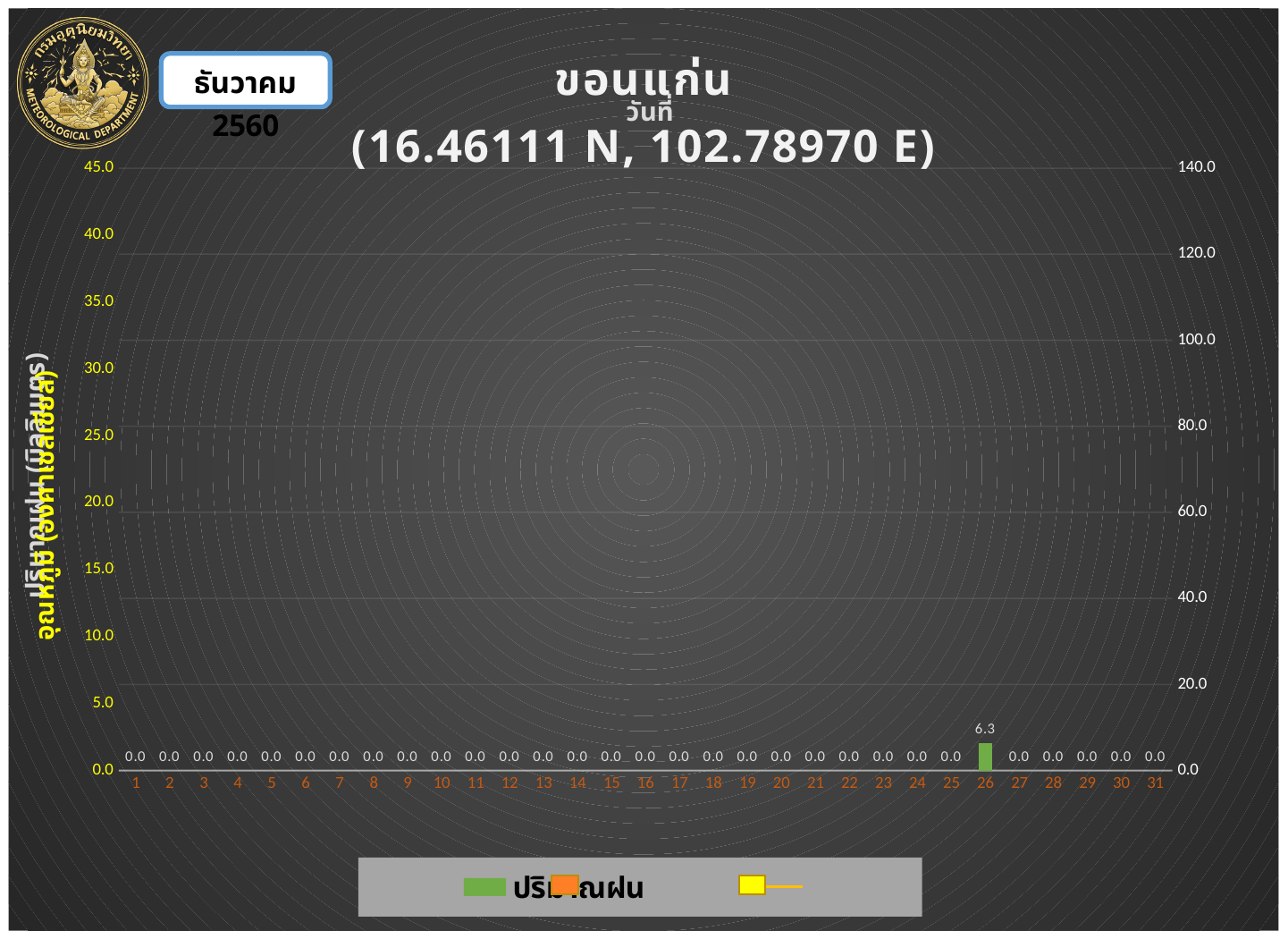
What is the difference between the rainfall value on day 26 and the value on day 25? 6.3 What is the rainfall value shown for day 15? 0.0 What is the rainfall value shown for day 26? 6.3 Is the rainfall value for day 26 greater or less than 10.0? less How many days are shown along the x axis? 31 What is the maximum value shown on the right vertical axis? 140.0 What is the rainfall value shown for day 1? 0.0 Which is larger, the rainfall value on day 26 or on day 27? day 26 Which day has the highest rainfall value? 26 What kind of chart is used to show the rainfall values? bar chart How many days have a rainfall value greater than 0.0? 1 What is the maximum value shown on the left vertical axis? 45.0